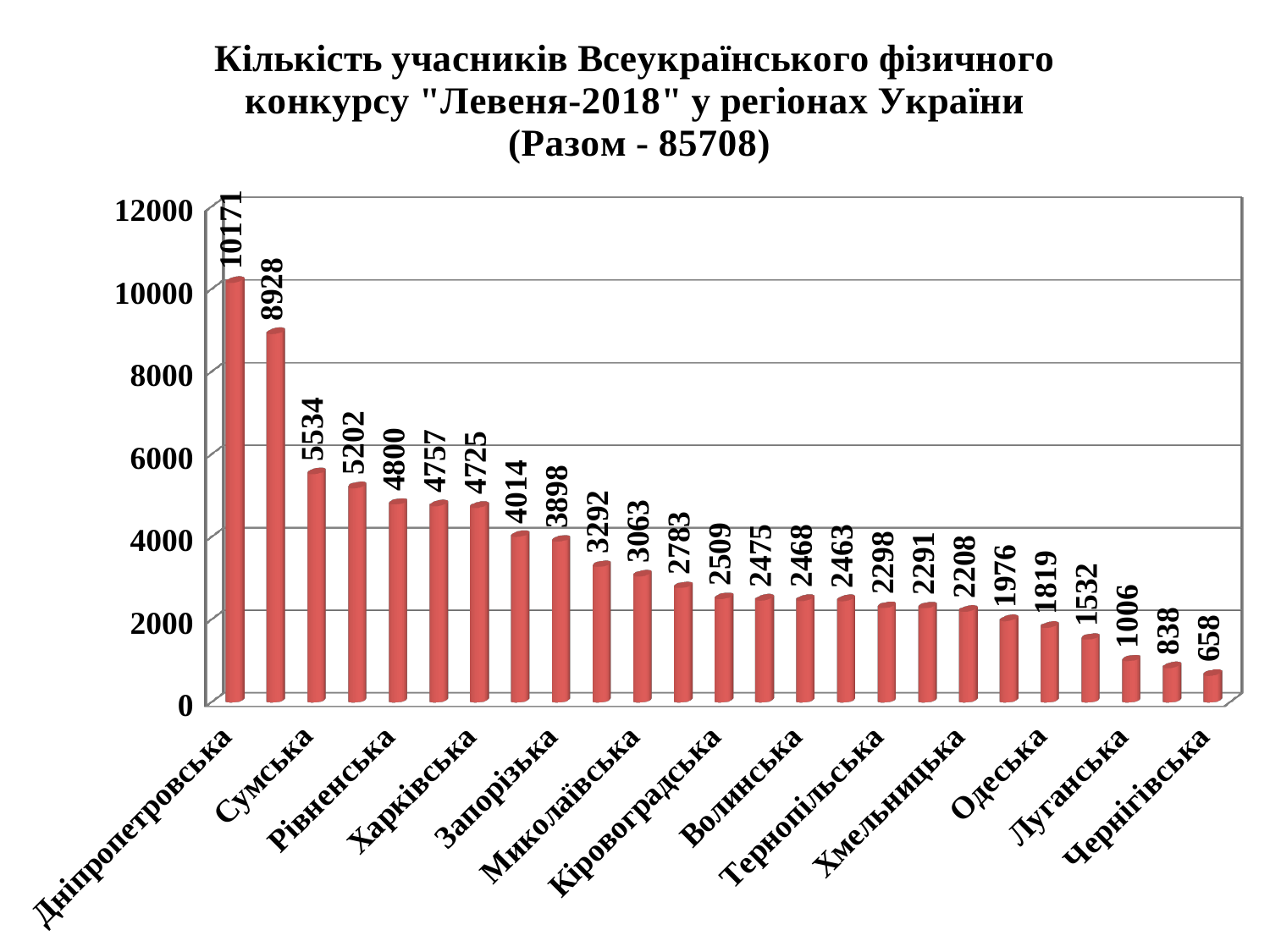
Which region has the lowest number of participants? Чернігівська What is the value of the second bar from the left? 8928 What type of chart is shown on the slide? bar chart What is the difference between the values for Дніпропетровська and Чернігівська? 9513 Which region has the highest number of participants? Дніпропетровська What is the value of the highest bar? 10171 What is the value for Чернігівська? 658 Which is larger, the value for Дніпропетровська or the value for Чернігівська? Дніпропетровська How many bars are plotted in the chart? 25 Is the value for Дніпропетровська greater or less than 10000? greater What total number of participants is given in the chart title? 85708 Do the values rise or fall from left to right along the x axis? fall